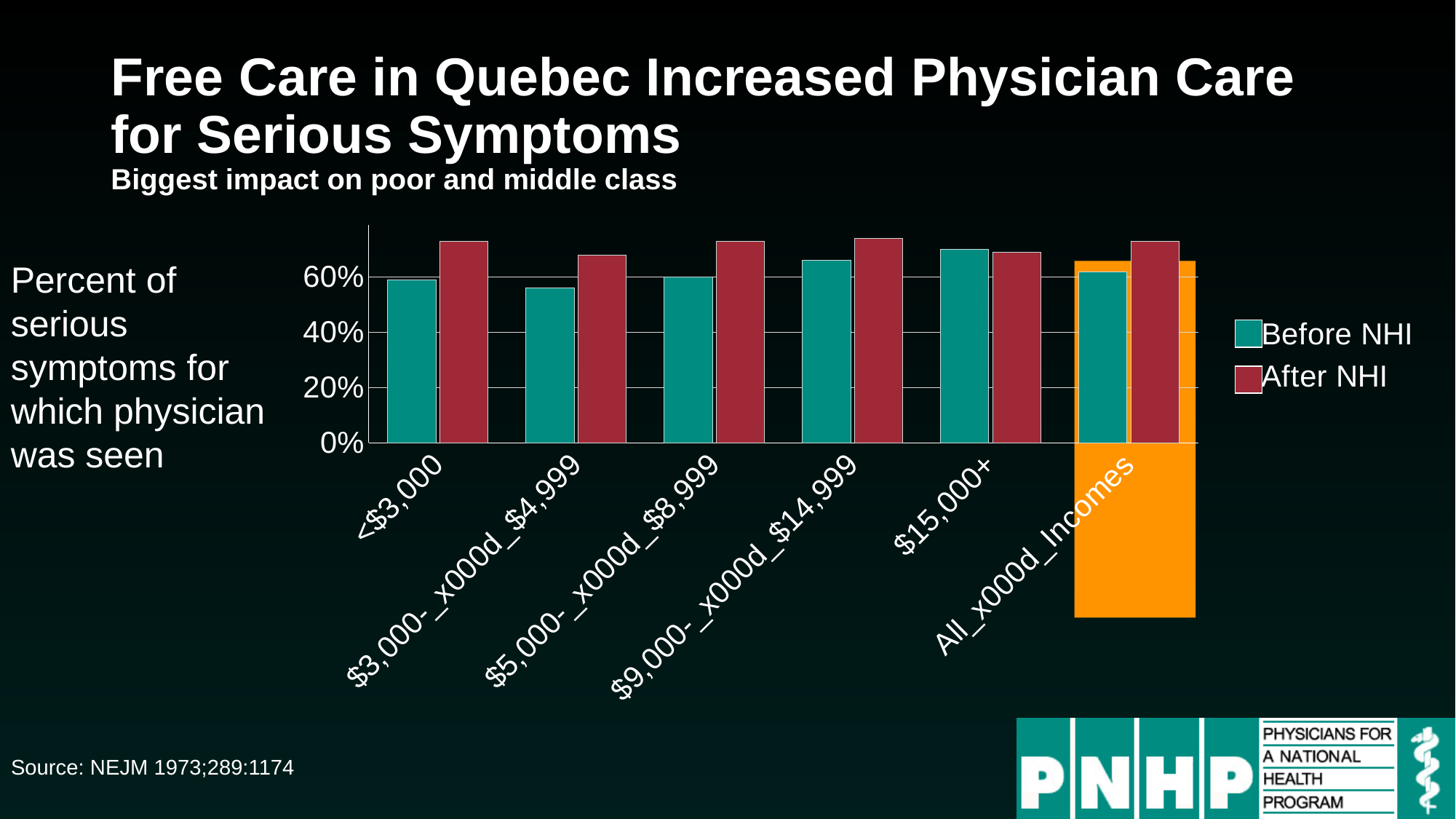
Which income category has the lowest Before NHI value? $3,000-$4,999 Which income category has the highest Before NHI value? $15,000+ Which income category is highlighted with an orange box? All Incomes How many income categories are shown on the x axis? 6 For the <$3,000 category, which is larger: Before NHI or After NHI? After NHI Is the Before NHI value for $15,000+ greater or less than 60%? greater How many series does the legend list? 2 What are the two series named in the legend? Before NHI and After NHI Is the Before NHI value for $3,000-$4,999 greater or less than 60%? less Is the After NHI value for All Incomes greater or less than 60%? greater What kind of chart is shown on the slide? bar chart